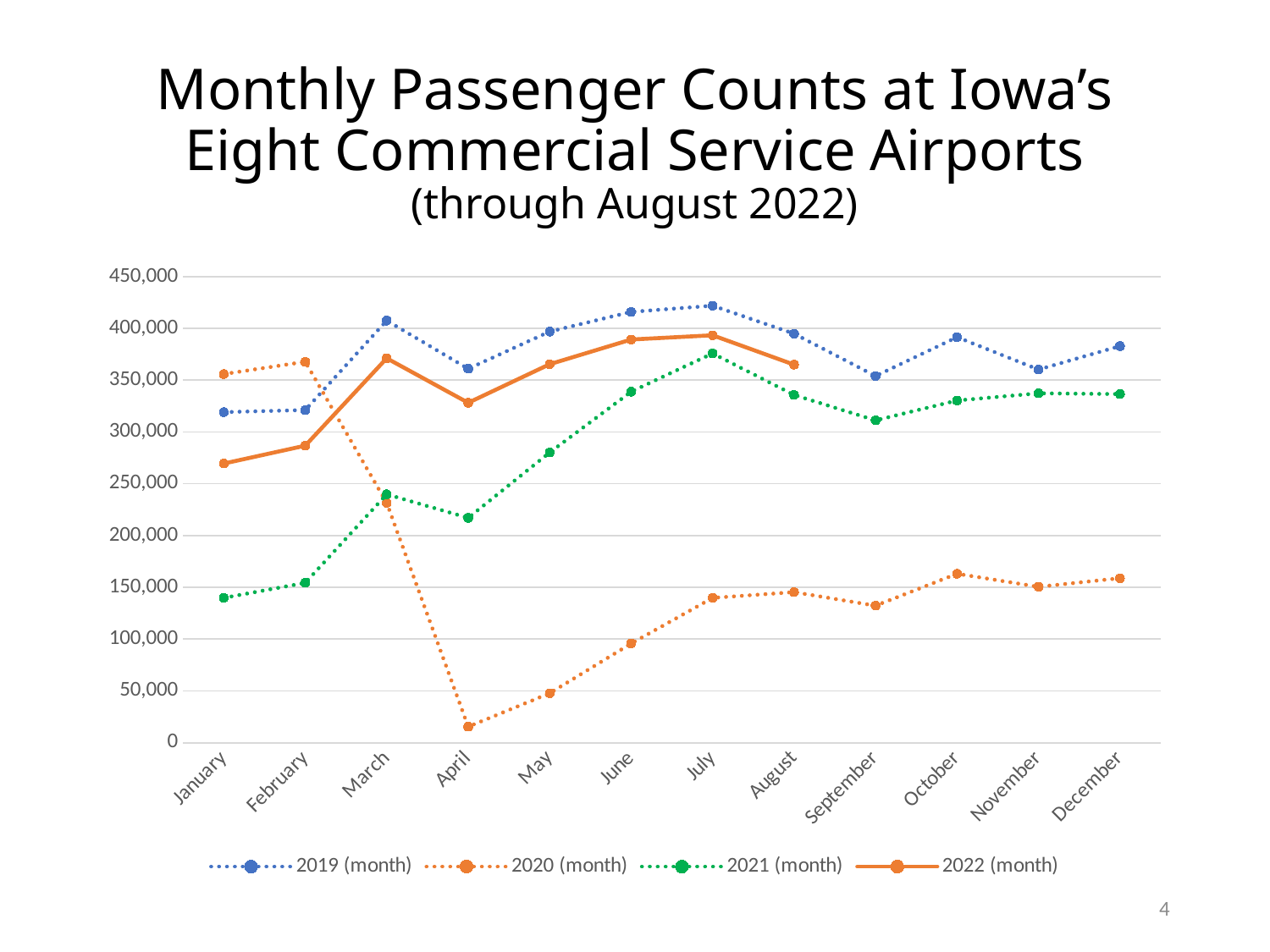
Which series is drawn with a solid line rather than a dotted line? 2022 (month) In January, which series has the larger value: 2020 (month) or 2022 (month)? 2020 (month) In which month is the 2021 (month) series at its highest? July Is the value for July in the 2022 (month) series greater or less than 350,000? greater Does the 2020 (month) series rise or fall from February to April? fall How many months are shown along the x axis? 12 Is the value for April in the 2020 (month) series greater or less than 50,000? less What kind of chart is shown on the slide? line chart How many series does the legend list? 4 In which month is the 2020 (month) series at its lowest? April Is the value for January in the 2021 (month) series greater or less than 150,000? less In January, which series has the larger value: 2019 (month) or 2021 (month)? 2019 (month)